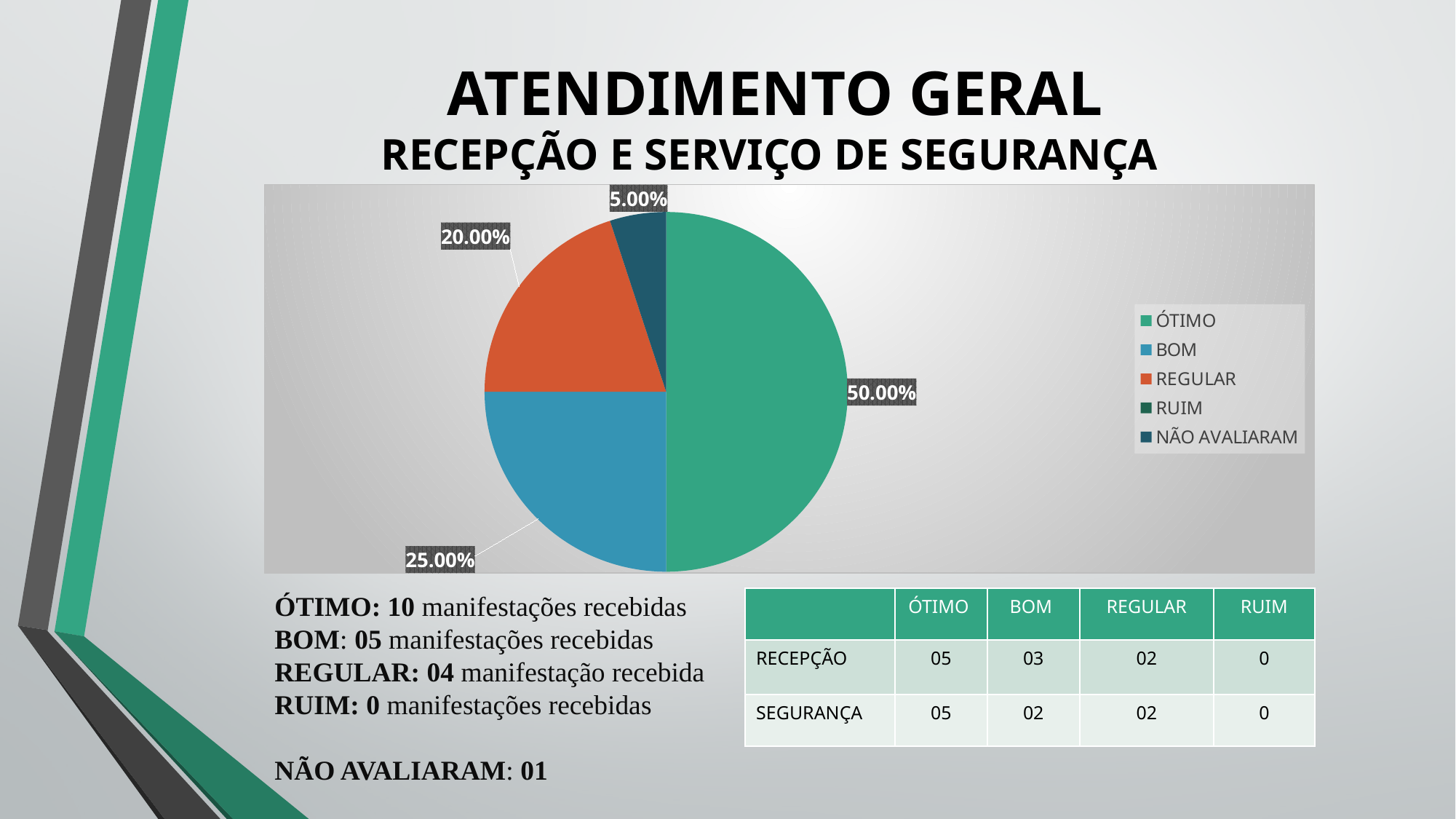
What percentage is shown for the BOM slice in the pie chart? 25.00% What colour represents ÓTIMO in the pie chart? Green How many entries does the pie chart's legend list? 5 What percentage is shown for the REGULAR slice in the pie chart? 20.00% Which slice is larger in the pie chart, REGULAR or BOM? BOM What is the difference in percentage points between the ÓTIMO and BOM slices? 25.00% What type of chart is shown on the slide? Pie chart What is the difference in percentage points between the BOM and REGULAR slices? 5.00% Which labelled slice in the pie chart is the smallest? NÃO AVALIARAM What percentage of the pie chart does the ÓTIMO slice represent? 50.00% Which category has the largest slice in the pie chart? ÓTIMO What percentage is shown for the NÃO AVALIARAM slice in the pie chart? 5.00%